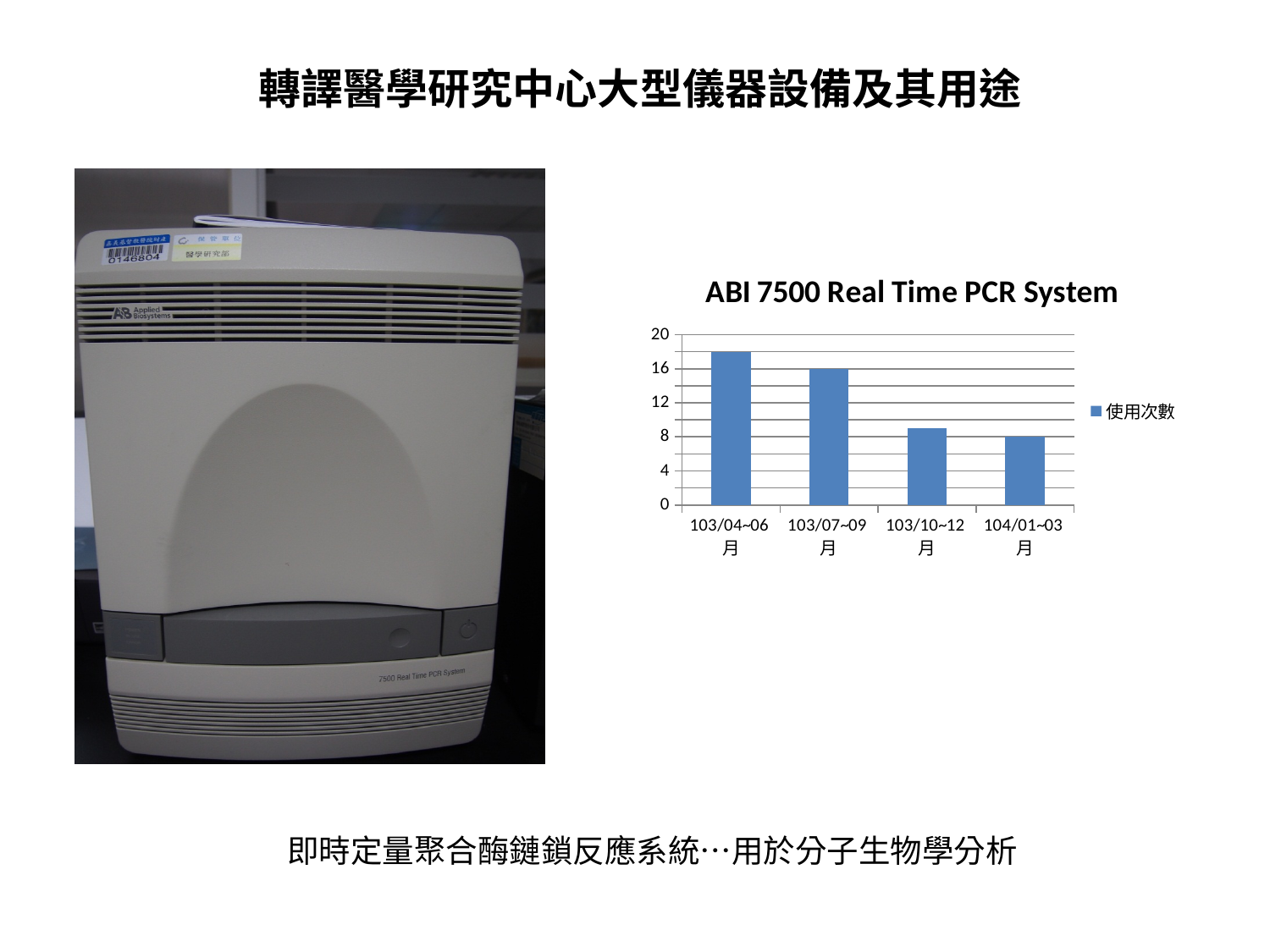
Is the value for 103/10~12月 greater or less than 12? less How many categories are shown on the x axis of the chart? 4 What is the value for 103/07~09月? 16 What is the value for 104/01~03月? 8 Which category has the highest value in the chart? 103/04~06月 What is the title of the chart? ABI 7500 Real Time PCR System What kind of chart is shown on the slide? bar chart Is the value for 103/04~06月 greater or less than 16? greater How many series does the chart legend list? 1 What is the name of the series shown in the chart legend? 使用次數 Which is larger, the value for 103/07~09月 or the value for 103/10~12月? 103/07~09月 Do the values rise or fall from left to right along the x axis? fall